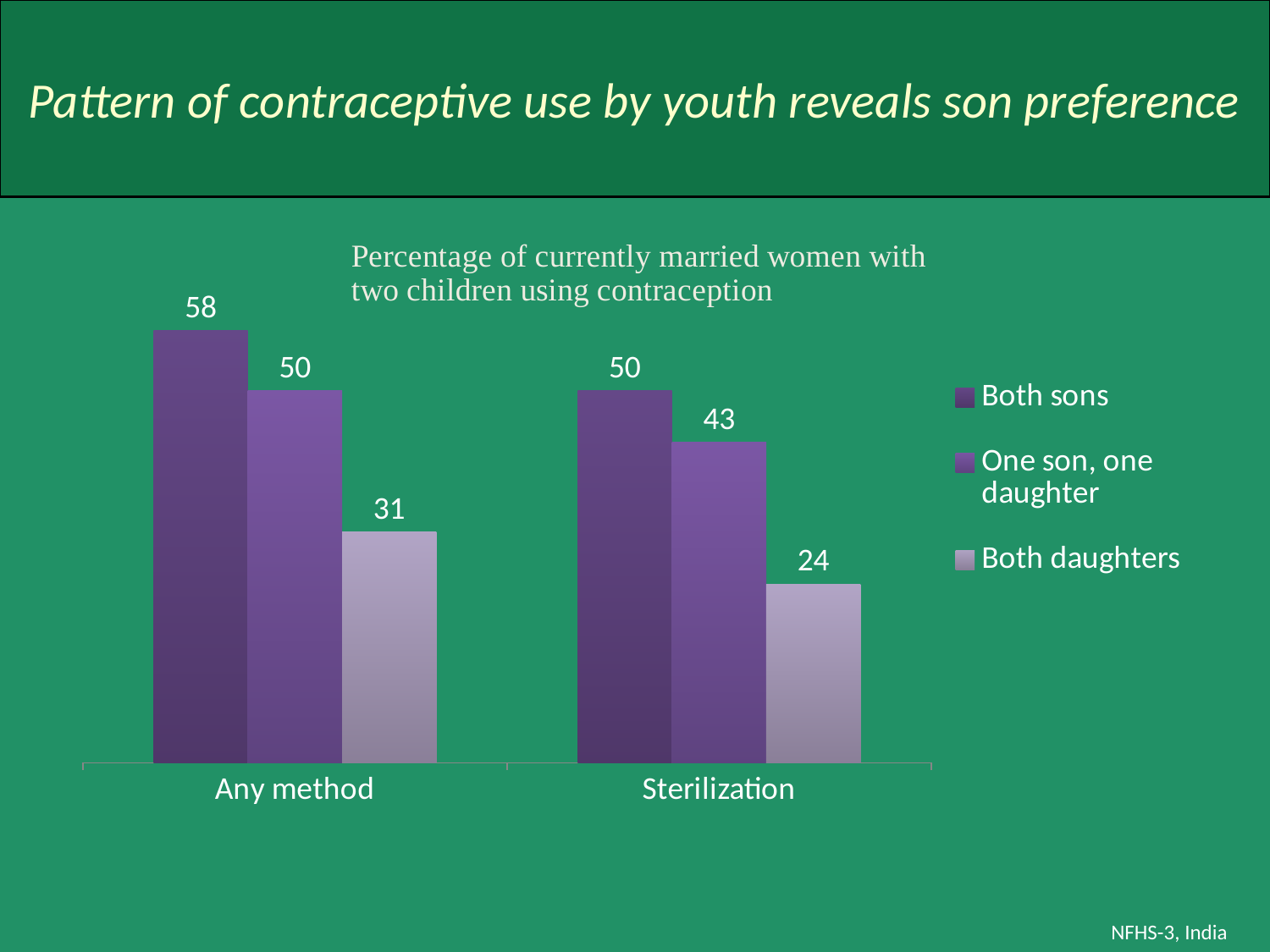
What is the value for Both sons in the Any method category? 58 What is the value for One son, one daughter in the Sterilization category? 43 Which series has the lowest value in the Sterilization category? Both daughters Which series has the highest value in the Any method category? Both sons Which is larger: the Both daughters value for Any method or the Both daughters value for Sterilization? Any method What kind of chart is shown on the slide? Bar chart How many series does the legend list? 3 What is the value for Both daughters in the Sterilization category? 24 How many categories are shown on the x axis? 2 What is the difference between the Both sons and One son, one daughter values in the Sterilization category? 7 What is the difference between the Both sons and Both daughters values in the Any method category? 27 What is the title of the chart? Percentage of currently married women with two children using contraception